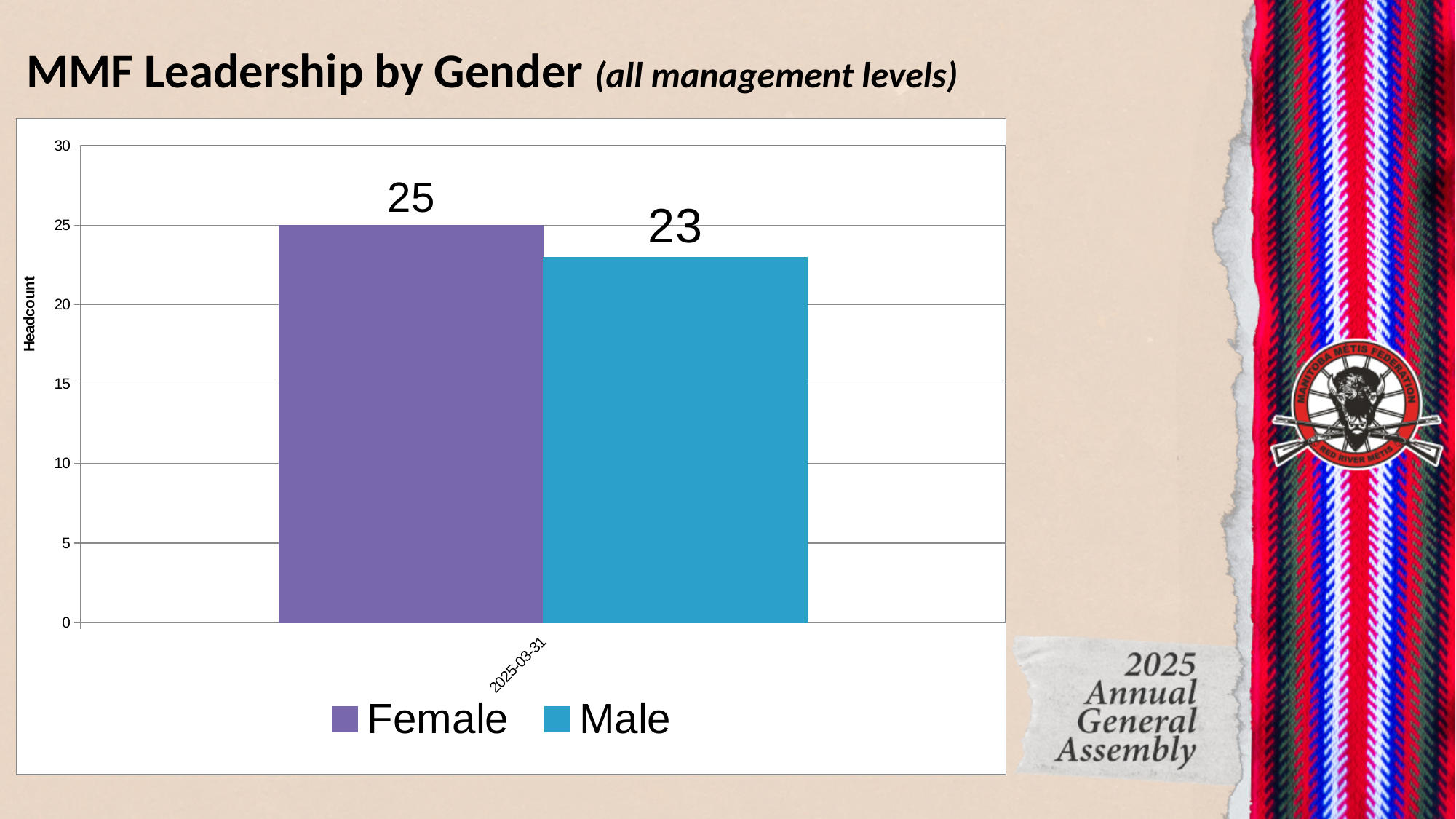
What is the Female headcount shown in the chart? 25 What is the combined headcount of Female and Male leaders? 48 What is the label of the vertical axis? Headcount Which series has the lowest headcount? Male How many series does the legend list? 2 What is the Male headcount shown in the chart? 23 What date is shown on the x axis of the chart? 2025-03-31 What kind of chart is shown on the slide? Bar chart What is the highest value shown on the vertical axis? 30 Which series has the higher headcount, Female or Male? Female What is the difference between the Female and Male headcounts? 2 Is the Male headcount greater or less than 25? less